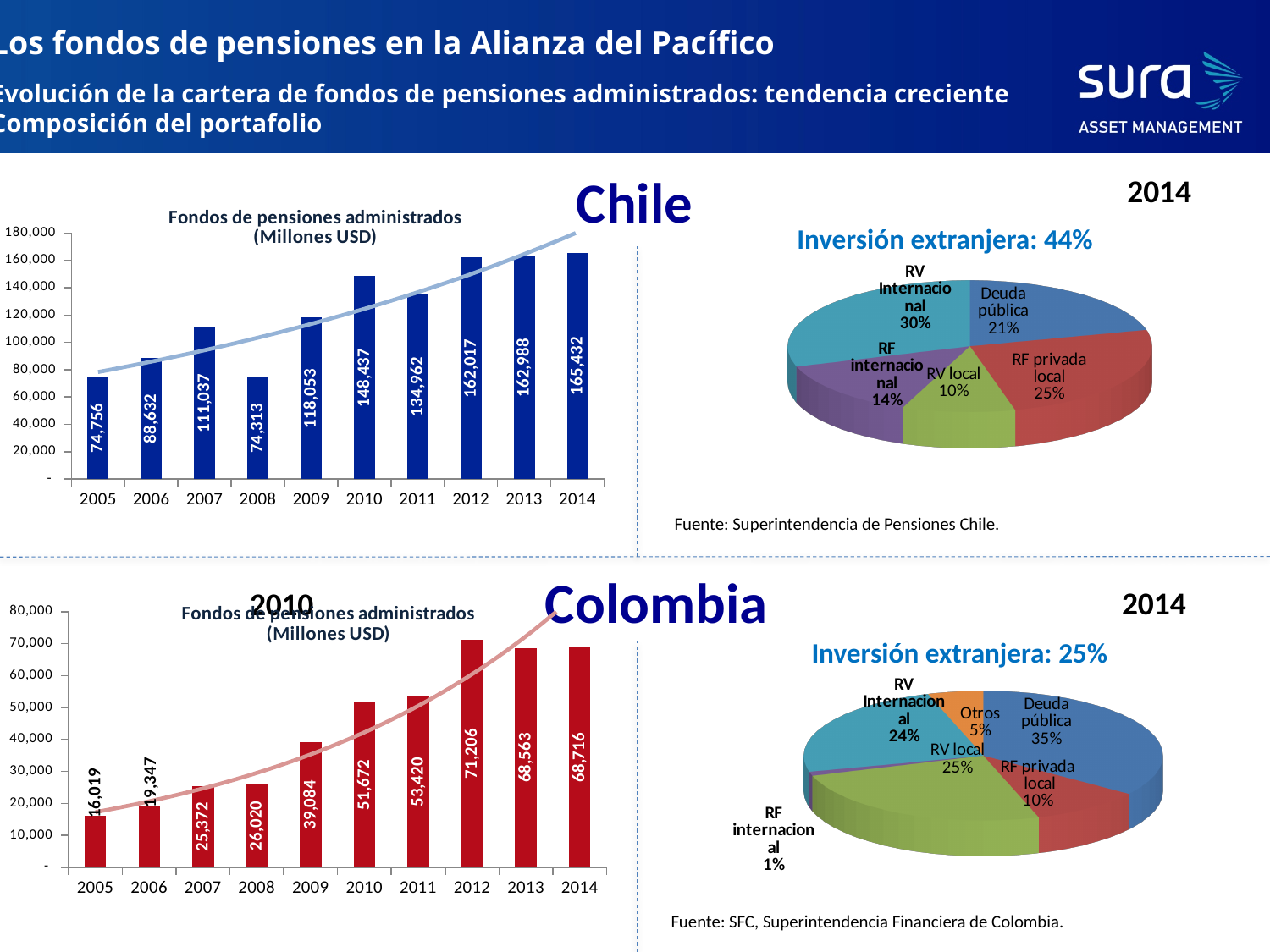
In the Colombia bar chart, is the value for 2013 larger or smaller than the value for 2014? smaller In the Chile bar chart (Fondos de pensiones administrados), what is the value for 2010? 148,437 In the Colombia bar chart (Fondos de pensiones administrados), what is the value for 2012? 71,206 In the Chile bar chart, which year has the lowest value? 2008 What type of chart is used to show Fondos de pensiones administrados for Chile? bar chart In the Colombia bar chart, which year has the lowest value? 2005 In the Chile bar chart, what is the difference between the 2014 value and the 2005 value? 90,676 In the Chile bar chart, which year has the highest value? 2014 How many slices does the Colombia pie chart have? 6 In the Chile pie chart, which slice is the largest? RV Internacional In the Chile pie chart (Inversión extranjera: 44%), what share does Deuda pública have? 21% In the Colombia pie chart (Inversión extranjera: 25%), what share does RF internacional have? 1%